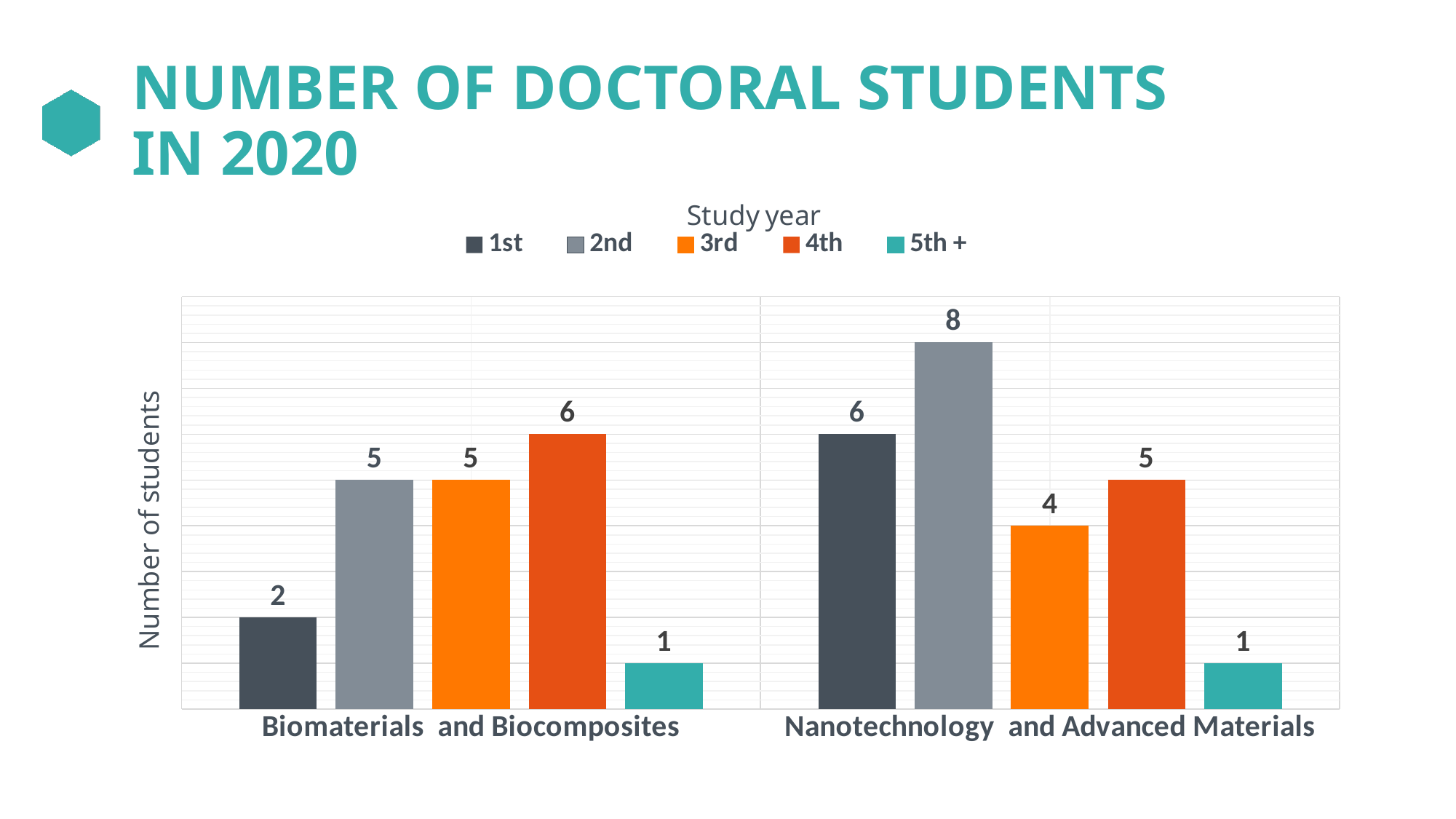
How many 2nd-year doctoral students are in Nanotechnology and Advanced Materials? 8 How many 3rd-year doctoral students are in Nanotechnology and Advanced Materials? 4 How many programme categories are shown on the x axis? 2 How many 1st-year doctoral students are in Biomaterials and Biocomposites? 2 What kind of chart is shown on the slide? Bar chart How many 4th-year doctoral students are in Biomaterials and Biocomposites? 6 Which study year has the fewest doctoral students in Biomaterials and Biocomposites? 5th + Which programme has more 4th-year doctoral students, Biomaterials and Biocomposites or Nanotechnology and Advanced Materials? Biomaterials and Biocomposites Which study year has the most doctoral students in Nanotechnology and Advanced Materials? 2nd What is the title of the legend above the chart? Study year What is the difference between the number of 1st-year students in Nanotechnology and Advanced Materials and in Biomaterials and Biocomposites? 4 How many series does the legend list? 5